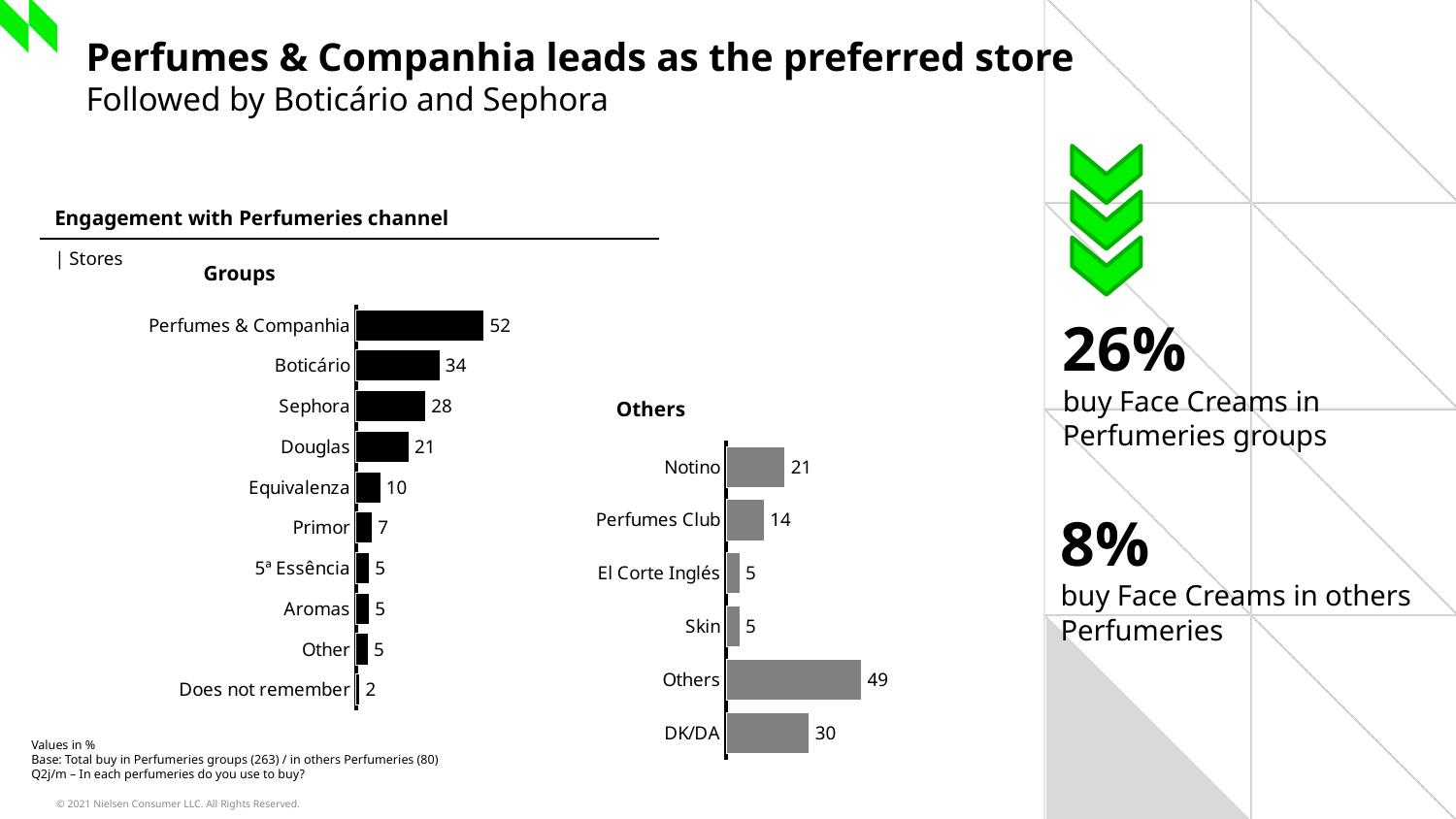
How many categories are shown in the Groups chart? 10 In the Others chart, what is the value for DK/DA? 30 In the Others chart, what is the value for Perfumes Club? 14 What type of chart is the Others chart? Bar chart In the Groups chart, what is the value for Douglas? 21 In the Others chart, which category has the highest value? Others In the Groups chart, which store has the highest value? Perfumes & Companhia In the Groups chart, which is larger, Equivalenza or Primor? Equivalenza In the Groups chart, what is the difference between Boticário and Sephora? 6 In the Groups chart, which category has the lowest value? Does not remember In the Groups chart, what is the value for Perfumes & Companhia? 52 In the Others chart, what is the difference between Notino and Perfumes Club? 7